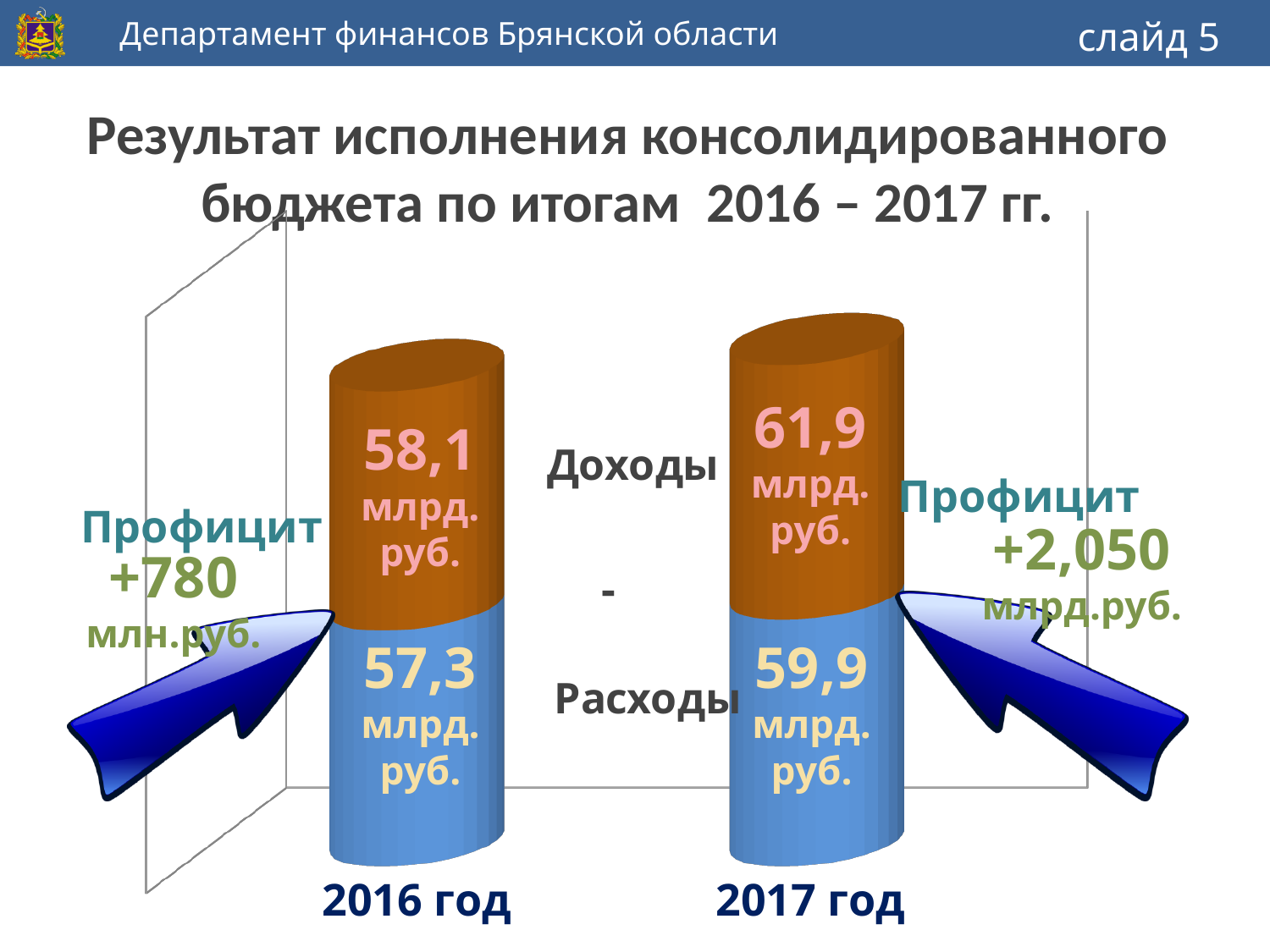
What is the value of Расходы for 2016 год? 57,3 млрд. руб. What is the value of Расходы for 2017 год? 59,9 млрд. руб. What is the value of Доходы for 2017 год? 61,9 млрд. руб. What is the Профицит shown for 2017 год? +2,050 млрд.руб. By how much did Доходы increase from 2016 год to 2017 год? 3,8 млрд. руб. How many years (categories) are shown in the chart? 2 In 2017 год, which is larger: Доходы or Расходы? Доходы By how much did Расходы increase from 2016 год to 2017 год? 2,6 млрд. руб. Which year has the lower Расходы value? 2016 год Which year has the higher Доходы value? 2017 год What kind of chart is shown on the slide? Bar chart What is the value of Доходы for 2016 год? 58,1 млрд. руб.